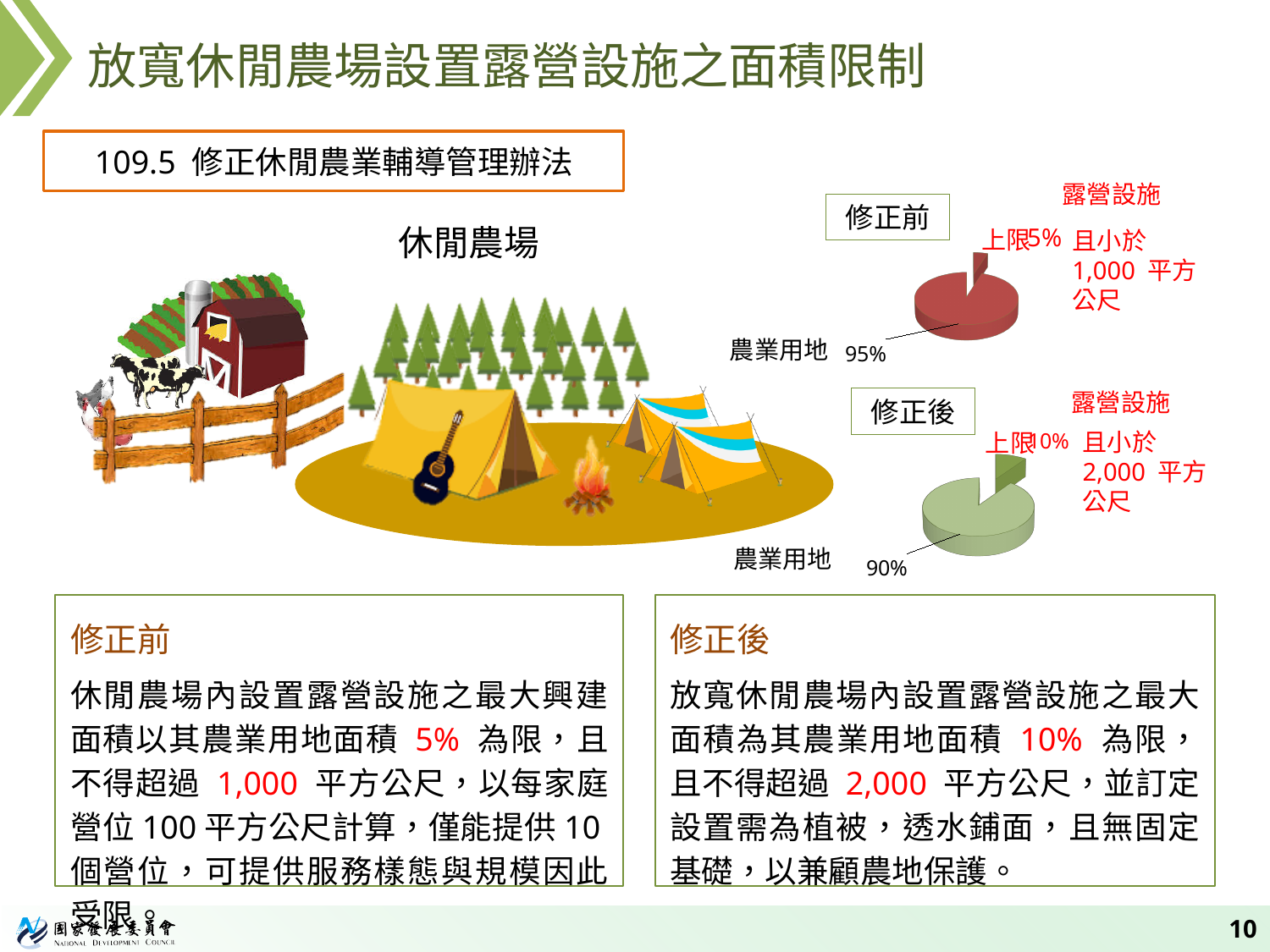
What colour is the 修正前 pie chart? Red In the 修正後 pie chart, which category has the smallest slice? 露營設施 In the 修正後 pie chart, what upper limit is shown for 露營設施? 上限10% In the 修正後 pie chart, what share is labelled for 農業用地? 90% In the 修正前 pie chart, which category has the largest slice? 農業用地 In the 修正前 pie chart, what upper limit is shown for 露營設施? 上限5% What type of chart is used for 修正前 and 修正後? Pie chart In the 修正前 pie chart, what share is labelled for 農業用地? 95% What is the difference between the 農業用地 share in the 修正前 chart and in the 修正後 chart? 5% What is the maximum area in square metres noted next to the 修正後 pie chart for 露營設施? 2,000 平方公尺 How many slices does the 修正後 pie chart have? 2 Is the 露營設施 share larger in the 修正前 chart or the 修正後 chart? 修正後